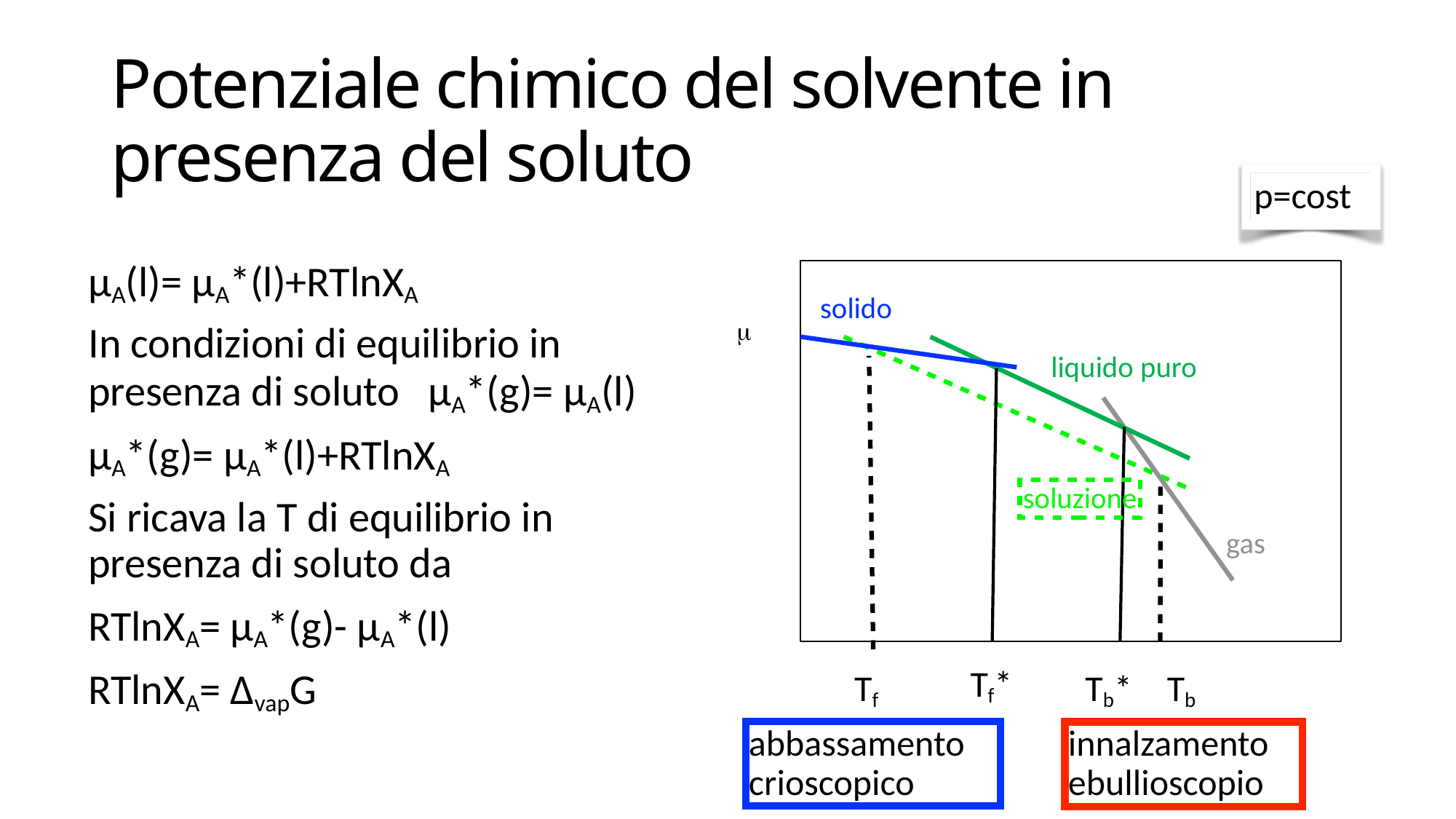
How many temperature labels are marked along the x axis of the chart? 4 What kind of chart is shown on the slide? line chart Which line in the chart lies lower, 'soluzione' or 'liquido puro'? soluzione What colour is the line labelled 'solido' in the chart? blue Do the lines in the chart rise or fall as temperature increases along the x axis? fall Which of the two temperatures marked on the x axis is further to the right, T_b* or T_b? T_b Which of the two temperatures marked on the x axis is further to the right, T_f or T_f*? T_f* What label is written on the y axis of the chart? μ How many labelled lines (phases) are drawn in the chart? 4